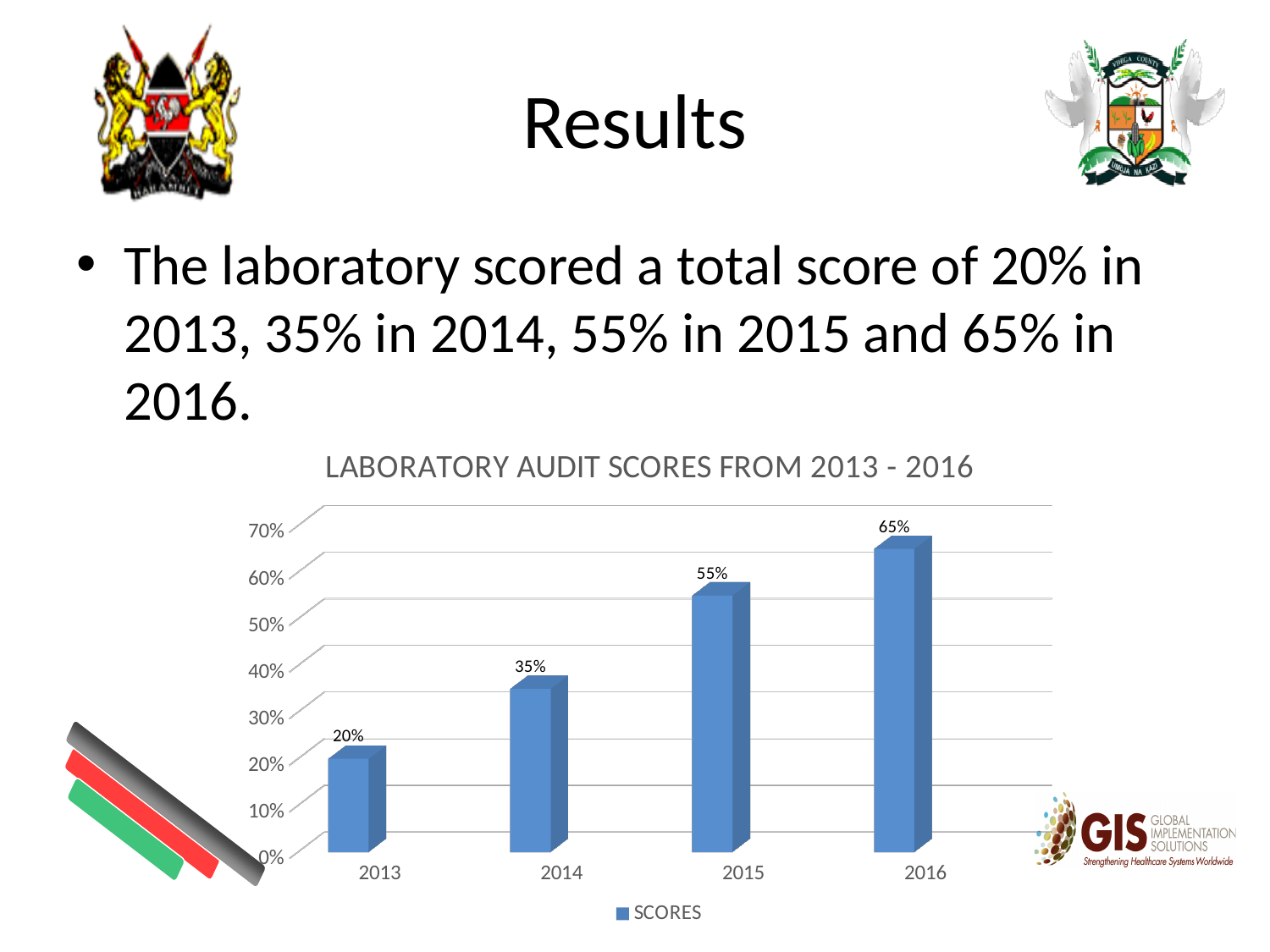
How many series does the chart legend list? 1 Which year has the larger score, 2014 or 2015? 2015 What kind of chart is shown on the slide? Bar chart Do the laboratory audit scores rise or fall from 2013 to 2016? Rise Which year has the lowest laboratory audit score? 2013 What is the difference between the 2015 score and the 2014 score? 20% What is the laboratory audit score for 2013? 20% What is the laboratory audit score for 2015? 55% Which year has the highest laboratory audit score? 2016 Is the score for 2014 greater or less than 40%? less How many years are shown on the x axis of the chart? 4 What is the difference between the 2016 score and the 2013 score? 45%